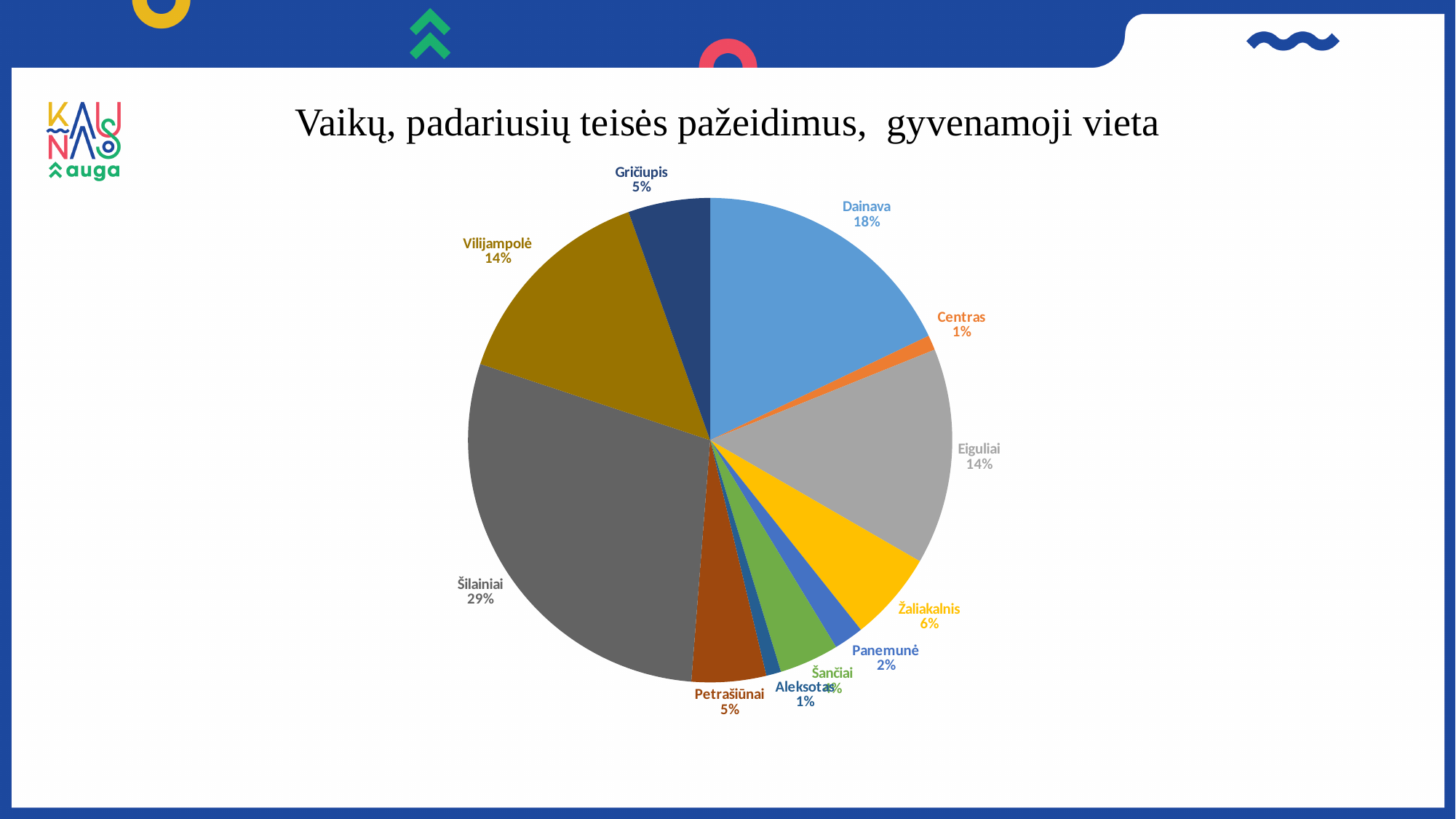
What type of chart is shown on the slide? pie chart How many categories are shown in the pie chart? 11 What is the value shown for Petrašiūnai? 5% What is the difference between the values for Šilainiai and Dainava? 11% What share of the pie does Šilainiai have? 29% Which category has the largest slice of the pie? Šilainiai What is the value shown for Vilijampolė? 14% What is the value shown for Panemunė? 2% What is the value shown for Dainava? 18% What is the value shown for Žaliakalnis? 6% Which is larger, the slice for Dainava or the slice for Eiguliai? Dainava What is the title of the chart? Vaikų, padariusių teisės pažeidimus, gyvenamoji vieta